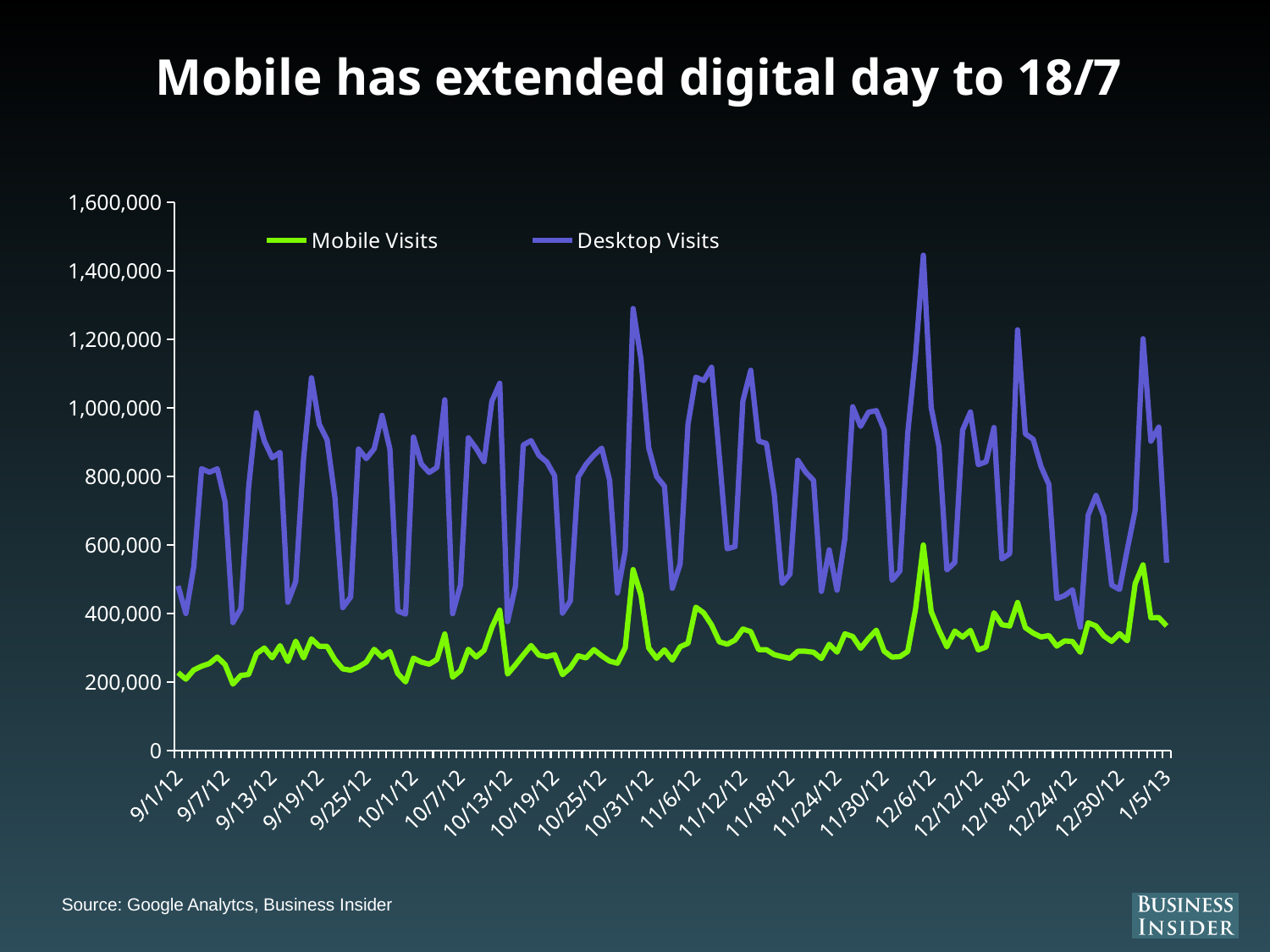
Is the value for Desktop Visits on 10/31/12 greater or less than 1,000,000? less How many date labels are shown on the x axis? 22 Is the highest Desktop Visits value, near 12/6/12, greater or less than 1,200,000? greater How many series does the legend list? 2 Do Mobile Visits generally rise or fall from 9/1/12 to 1/5/13? Rise Around which date does Desktop Visits reach its highest peak? 12/6/12 Is the Mobile Visits peak near 12/6/12 greater or less than 400,000? greater Which series has the higher values throughout the chart, Mobile Visits or Desktop Visits? Desktop Visits Which colour is used for the Mobile Visits line? Green What kind of chart is shown on the slide? Line chart What is the title of the chart on the slide? Mobile has extended digital day to 18/7